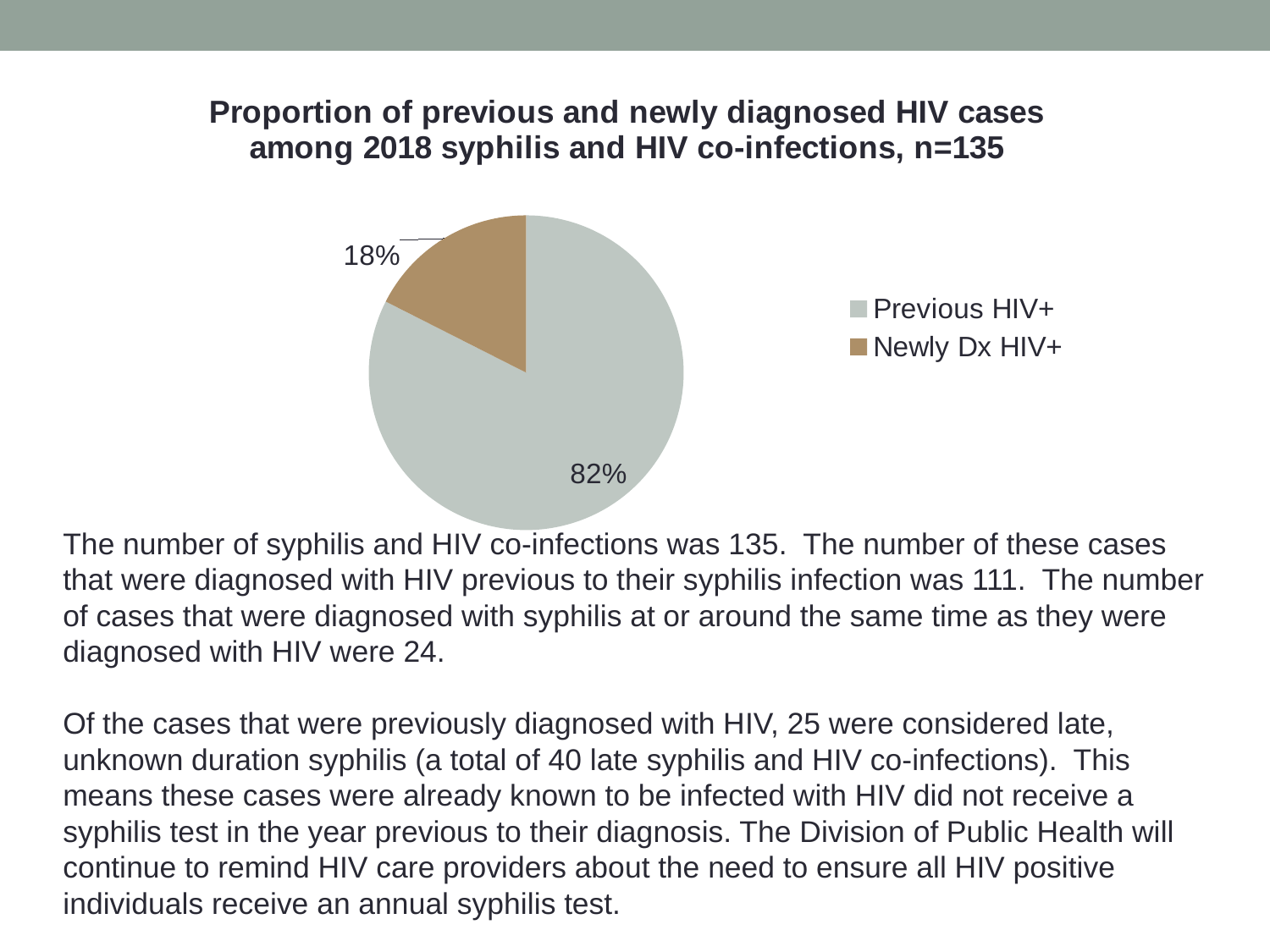
What percentage of the pie is Newly Dx HIV+? 18% What is the difference in percentage points between the Previous HIV+ and Newly Dx HIV+ slices? 64 How many entries does the legend list? 2 What is the title of the chart? Proportion of previous and newly diagnosed HIV cases among 2018 syphilis and HIV co-infections, n=135 Which legend entry is shown in the brown/tan colour? Newly Dx HIV+ How many slices does the pie chart have? 2 Which slice of the pie is the largest? Previous HIV+ What is the share of the pie taken by the Newly Dx HIV+ slice? 18% Which is larger, the Previous HIV+ slice or the Newly Dx HIV+ slice? Previous HIV+ What kind of chart is shown on the slide? pie chart Which slice of the pie is the smallest? Newly Dx HIV+ What percentage of the pie is Previous HIV+? 82%